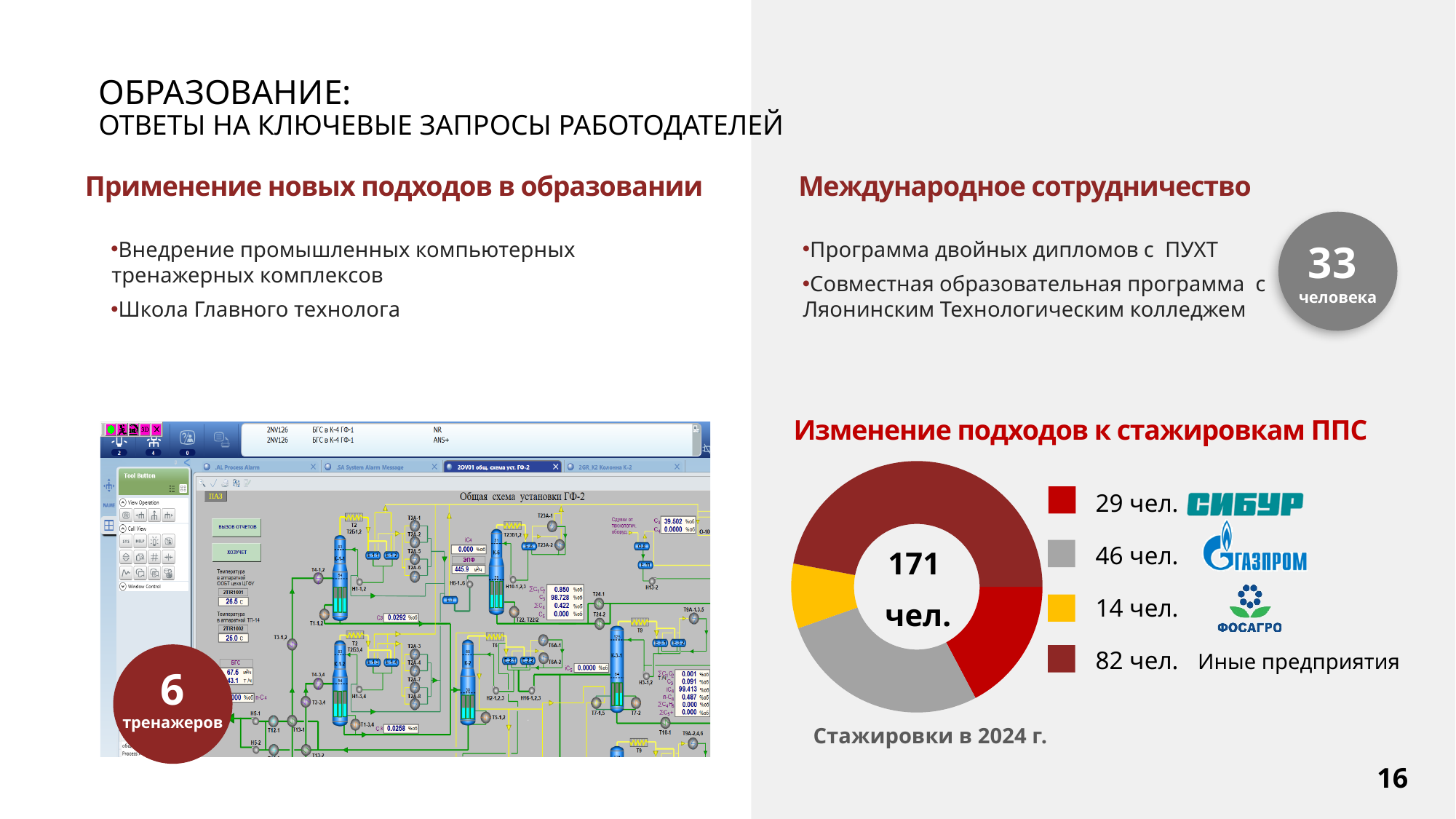
How many people did internships at ГАЗПРОМ according to the donut chart? 46 чел. How many people did internships at СИБУР according to the donut chart? 29 чел. What kind of chart is shown under the heading "Изменение подходов к стажировкам ППС"? Pie (donut) chart Which category has the smallest segment in the donut chart? ФОСАГРО Which category has the largest segment in the donut chart? Иные предприятия How many people did internships at ФОСАГРО according to the donut chart? 14 чел. What caption appears below the donut chart? Стажировки в 2024 г. How many people did internships at "Иные предприятия" according to the donut chart? 82 чел. What is the total number of people shown in the centre of the donut chart? 171 чел. Which is larger in the donut chart: the number of people at ГАЗПРОМ or at СИБУР? ГАЗПРОМ How many segments does the donut chart have? 4 What is the difference between the number of people at "Иные предприятия" and at ГАЗПРОМ in the donut chart? 36 чел.